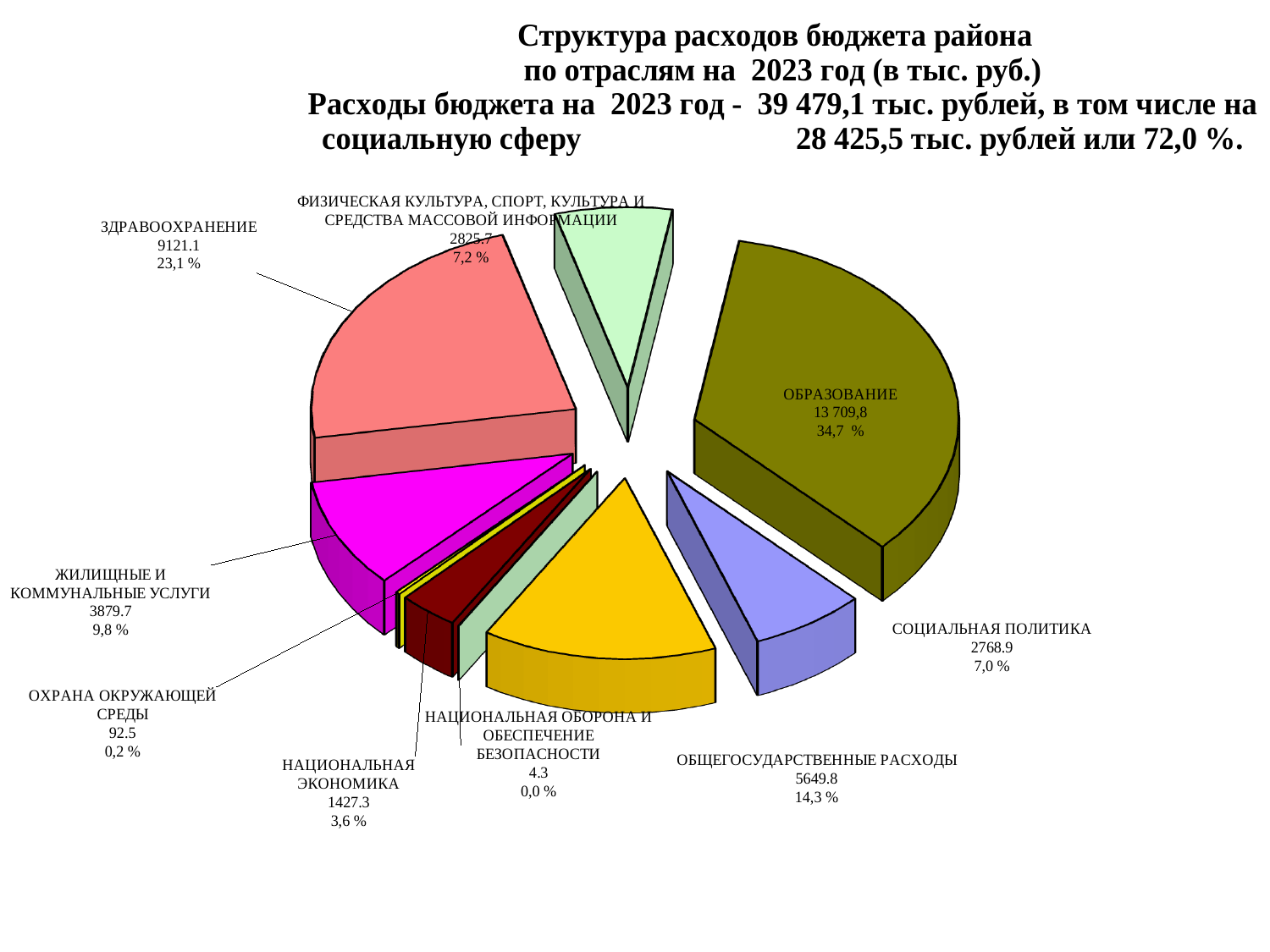
What is the value for ОБРАЗОВАНИЕ? 13 709,8 Which category has the smallest slice of the pie? НАЦИОНАЛЬНАЯ ОБОРОНА И ОБЕСПЕЧЕНИЕ БЕЗОПАСНОСТИ How many categories (slices) does the pie chart have? 9 What is the value for ЗДРАВООХРАНЕНИЕ? 9121.1 What kind of chart is shown on the slide? pie chart What share of the pie does СОЦИАЛЬНАЯ ПОЛИТИКА represent? 7,0 % What is the difference between the values for ЗДРАВООХРАНЕНИЕ and ЖИЛИЩНЫЕ И КОММУНАЛЬНЫЕ УСЛУГИ? 5241.4 What is the value for ОБЩЕГОСУДАРСТВЕННЫЕ РАСХОДЫ? 5649.8 Which category has the largest slice of the pie? ОБРАЗОВАНИЕ Which is larger, the value for ОБЩЕГОСУДАРСТВЕННЫЕ РАСХОДЫ or the value for СОЦИАЛЬНАЯ ПОЛИТИКА? ОБЩЕГОСУДАРСТВЕННЫЕ РАСХОДЫ What is the value for ОХРАНА ОКРУЖАЮЩЕЙ СРЕДЫ? 92.5 What share of the pie does ЖИЛИЩНЫЕ И КОММУНАЛЬНЫЕ УСЛУГИ represent? 9,8 %